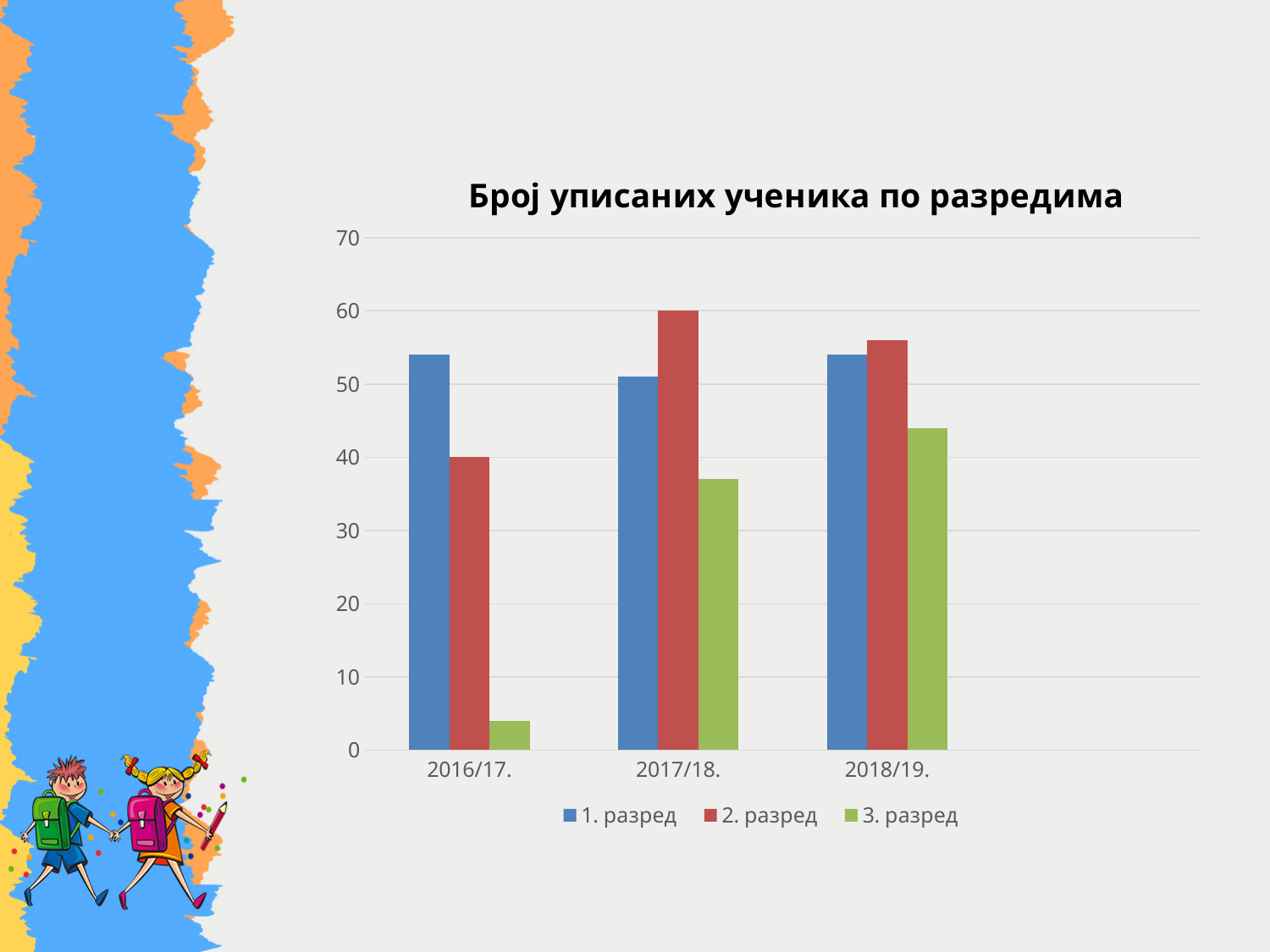
Is the value for 1. разред in 2018/19. greater or less than 50? greater What is the value for 2. разред in 2017/18.? 60 Do the values for 3. разред rise or fall from 2016/17. to 2018/19.? rise Which school year has the highest value for 2. разред? 2017/18. In 2017/18., which is larger: 1. разред or 2. разред? 2. разред How many school years are shown on the x axis? 3 What is the value for 2. разред in 2016/17.? 40 How many series does the legend list? 3 Is the value for 3. разред in 2016/17. greater or less than 10? less What type of chart is shown on the slide? bar chart Which school year has the lowest value for 3. разред? 2016/17. What is the title of the chart? Број уписаних ученика по разредима